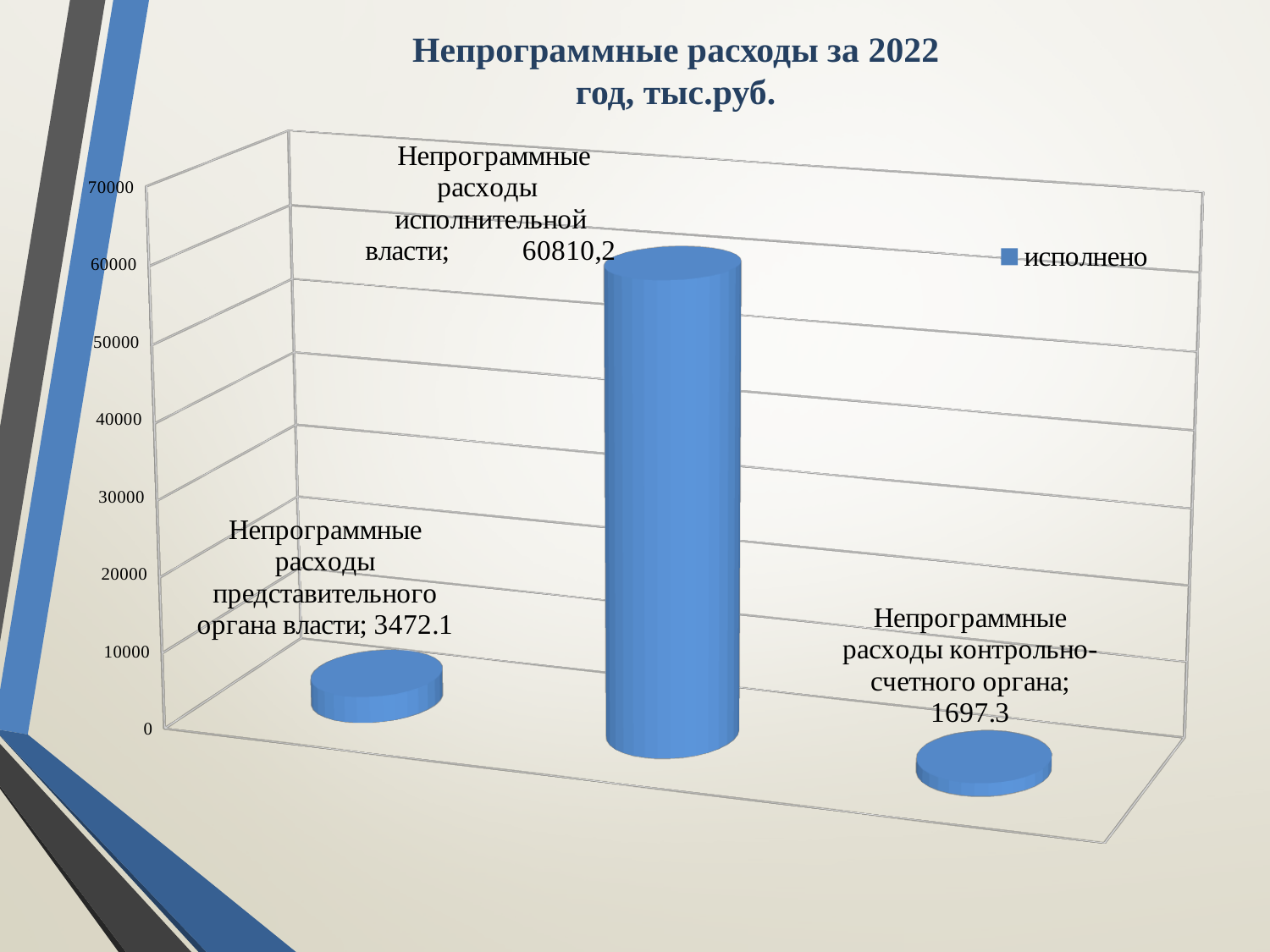
What is the title of the chart? Непрограммные расходы за 2022 год, тыс.руб. What kind of chart is shown on the slide? bar chart What is the difference between the value for Непрограммные расходы представительного органа власти and the value for Непрограммные расходы контрольно-счетного органа? 1774.8 Is the value for Непрограммные расходы исполнительной власти greater or less than 50000? greater Which category has the highest value? Непрограммные расходы исполнительной власти What is the value for Непрограммные расходы представительного органа власти? 3472.1 How many categories are shown in the chart? 3 How many series does the legend list? 1 What is the value for Непрограммные расходы исполнительной власти? 60810,2 Which category has the lowest value? Непрограммные расходы контрольно-счетного органа Which is larger: the value for Непрограммные расходы представительного органа власти or the value for Непрограммные расходы контрольно-счетного органа? Непрограммные расходы представительного органа власти What is the value for Непрограммные расходы контрольно-счетного органа? 1697.3